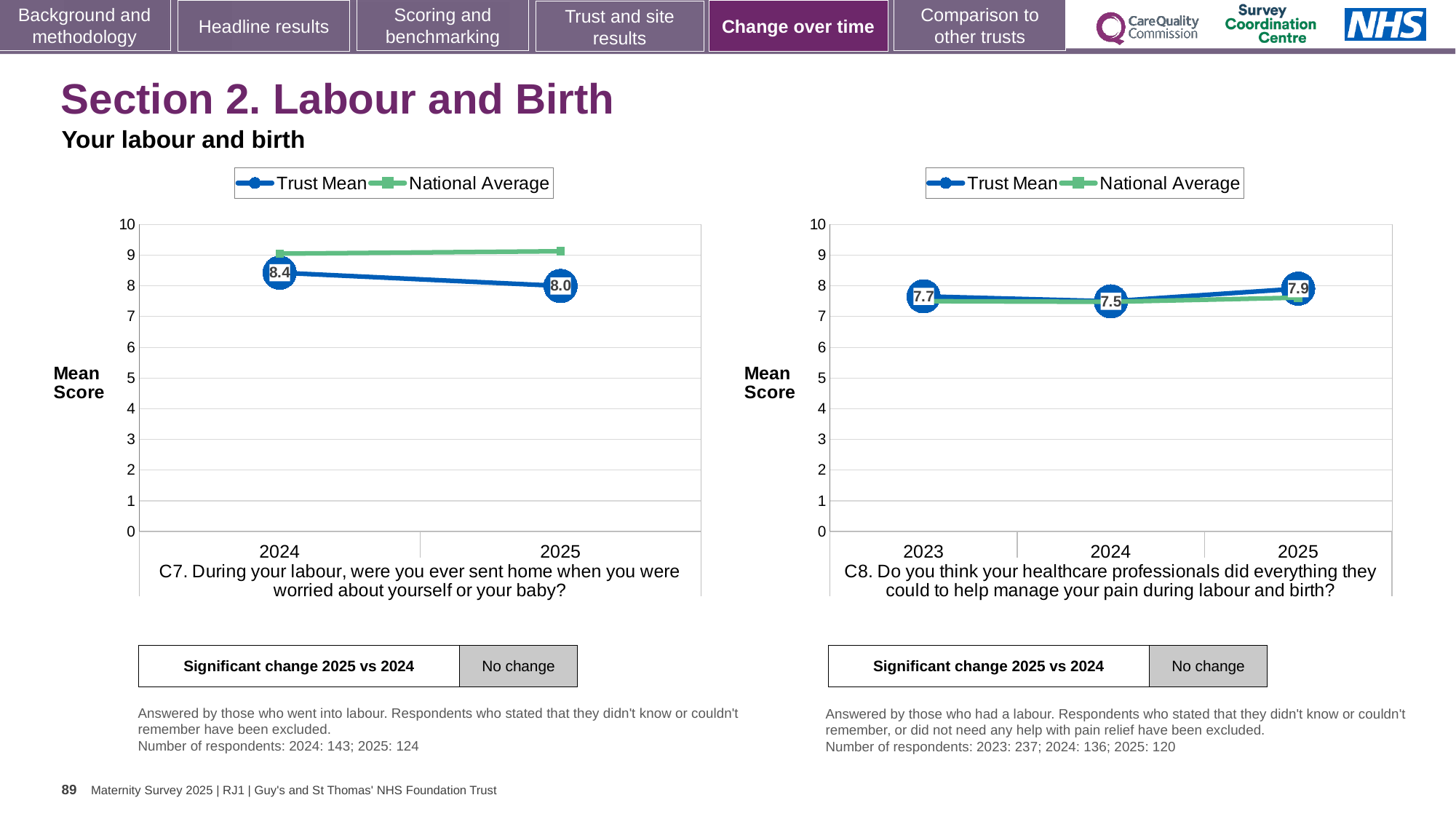
In the C8 chart on the right, what is the Trust Mean score for 2023? 7.7 How many years are plotted on the x axis of the C8 chart on the right? 3 In the C7 chart on the left, is the National Average for 2024 greater or less than 8? greater In the C8 chart on the right, which year has the highest Trust Mean score? 2025 In the C7 chart on the left, by how much did the Trust Mean score fall from 2024 to 2025? 0.4 In the C7 chart on the left, what is the Trust Mean score for 2025? 8.0 In the C8 chart on the right, what is the difference between the Trust Mean scores for 2025 and 2024? 0.4 In the C7 chart on the left, what is the Trust Mean score for 2024? 8.4 In the C7 chart on the left, which is higher in 2024, the Trust Mean or the National Average? National Average In the C8 chart on the right, which year has the lowest Trust Mean score? 2024 How many series does the legend of the C7 chart on the left list? 2 In the C8 chart on the right, what is the Trust Mean score for 2025? 7.9